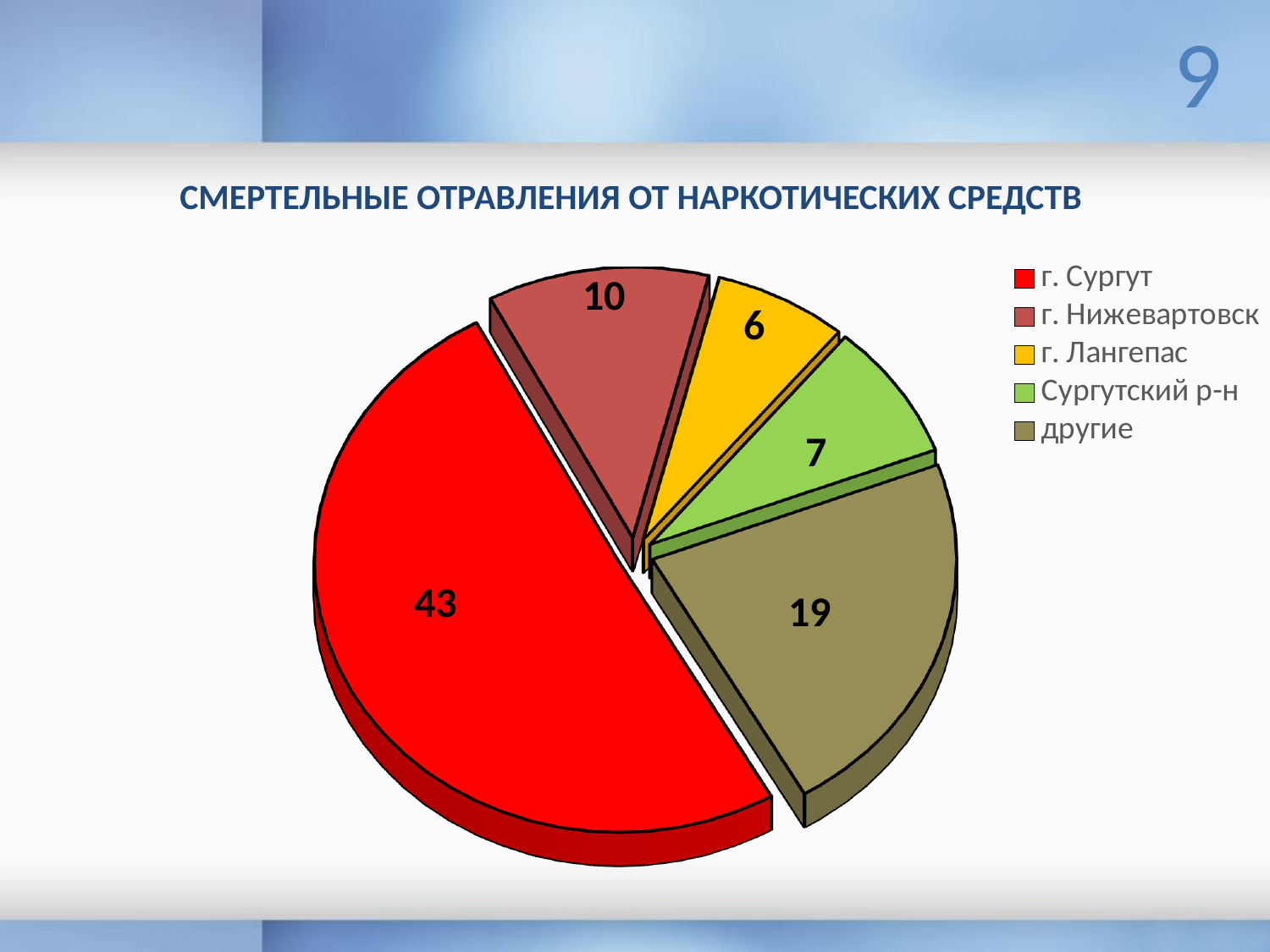
How many categories does the pie chart have? 5 What is the value for г. Нижевартовск? 10 What is the value for Сургутский р-н? 7 Which category has the largest slice? г. Сургут What is the title of the chart? СМЕРТЕЛЬНЫЕ ОТРАВЛЕНИЯ ОТ НАРКОТИЧЕСКИХ СРЕДСТВ What is the value for другие? 19 What is the value for г. Сургут? 43 What is the difference between the values for г. Сургут and другие? 24 Which is larger, the value for г. Нижевартовск or the value for Сургутский р-н? г. Нижевартовск What kind of chart is shown on the slide? Pie chart Which category has the smallest slice? г. Лангепас What is the value for г. Лангепас? 6